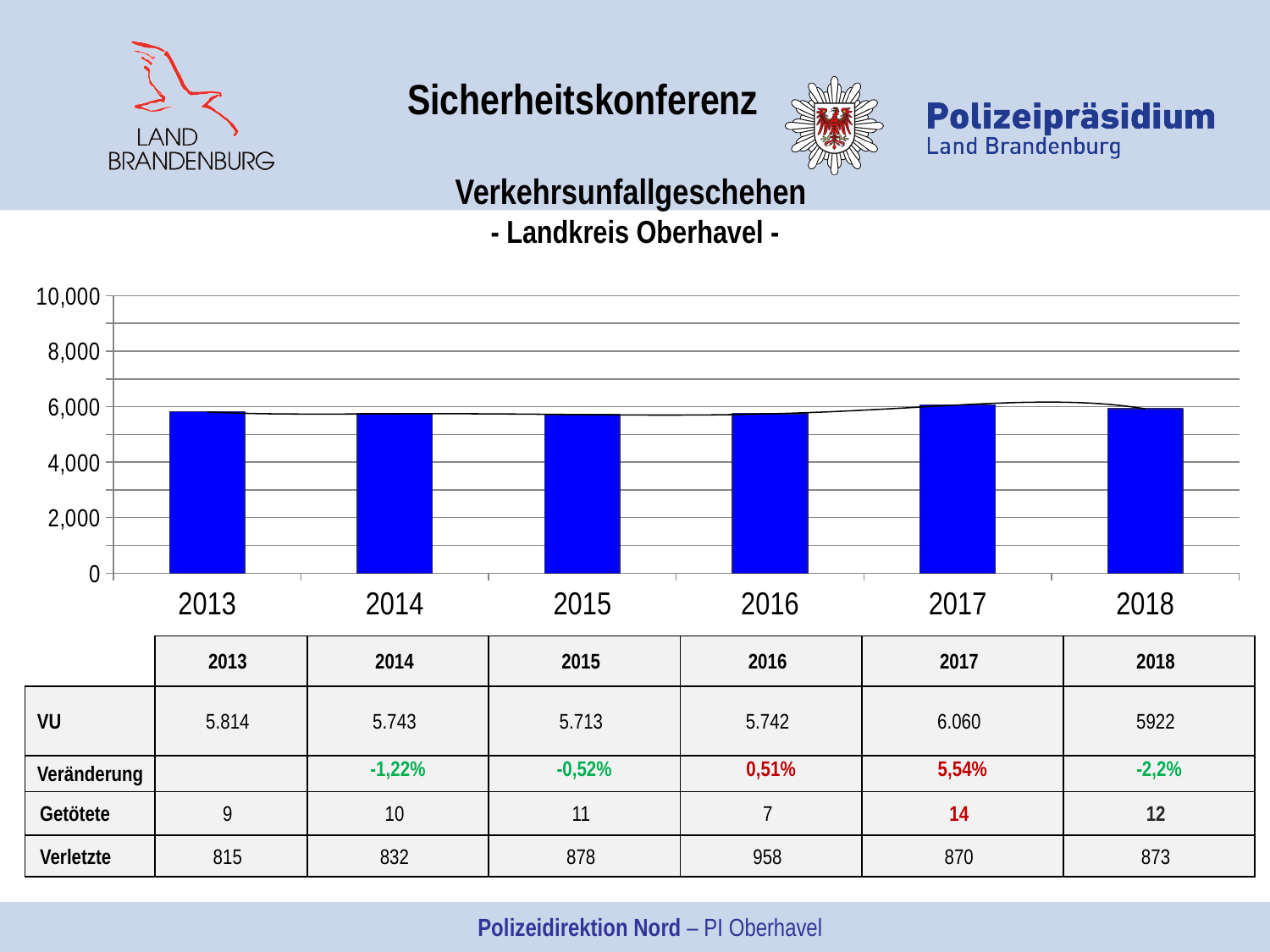
What kind of chart is shown on the slide? bar chart According to the table below the chart, what is the VU value for 2017? 6.060 According to the table below the chart, what is the VU value for 2013? 5.814 Is the bar for 2013 greater or less than 6,000? less Which year has the highest bar in the chart? 2017 Is the bar for 2015 greater or less than 4,000? greater Which bar is taller, 2017 or 2013? 2017 How many years (bars) are shown on the x axis of the chart? 6 According to the table below the chart, what is the VU value for 2018? 5922 Do the bar values rise or fall from 2013 to 2015? fall Using the VU values in the table, what is the difference between 2017 and 2013? 246 What colour are the bars in the chart? blue